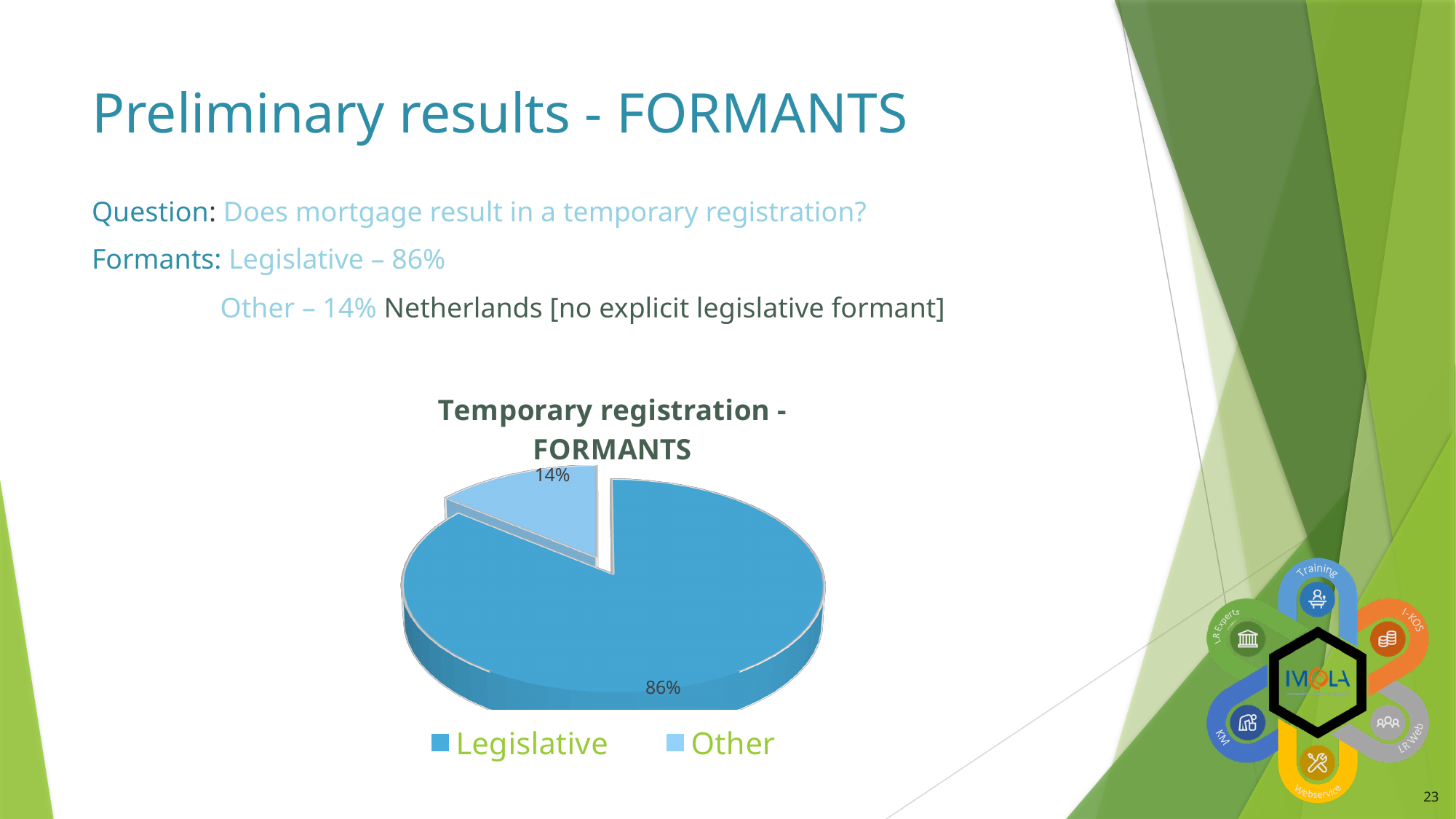
What is the difference in percentage points between Legislative and Other? 72 Which is larger, Legislative or Other? Legislative How many entries does the legend list? 2 Which legend entry is shown in the lighter blue colour? Other What type of chart is shown on the slide? pie chart Which slice is the largest? Legislative What share of the pie does Other have? 14% Which slice is the smallest? Other What is the chart's title? Temporary registration - FORMANTS How many slices does the pie chart have? 2 What share of the pie does Legislative have? 86%